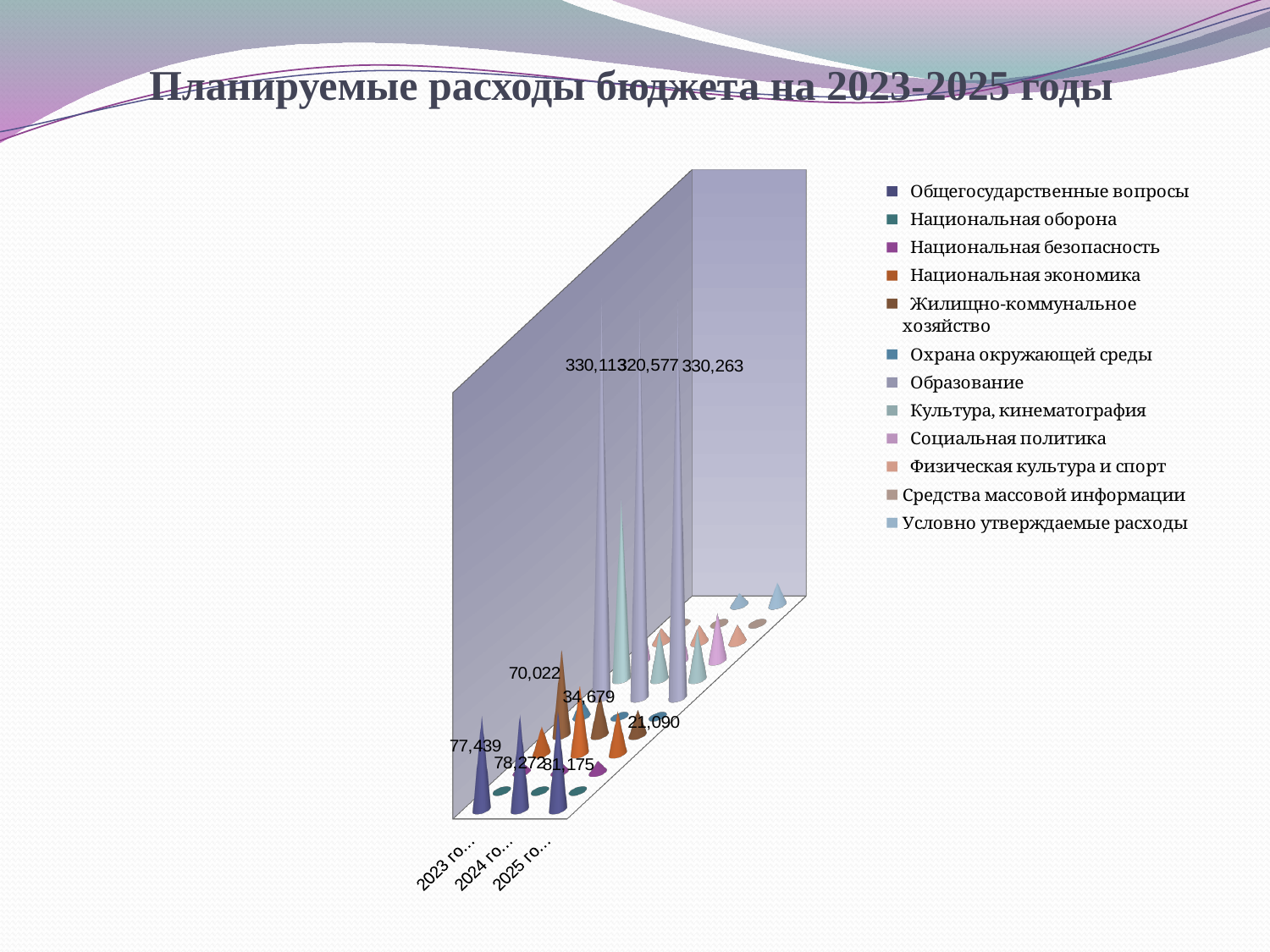
How many series does the legend list? 12 Do the values for Общегосударственные вопросы rise or fall from 2023 to 2025? rise Which is larger for Образование: the 2024 value or the 2025 value? 2025 What is the value for Образование in 2023? 330,113 What is the value for Общегосударственные вопросы in 2025? 81,175 What is the title of the slide? Планируемые расходы бюджета на 2023-2025 годы What is the value for Образование in 2025? 330,263 What is the value for Общегосударственные вопросы in 2023? 77,439 What is the difference between the Образование values for 2025 and 2024? 9,686 Which series has the highest values in the chart? Образование What is the difference between the Общегосударственные вопросы values for 2025 and 2023? 3,736 How many year categories are shown on the x axis? 3